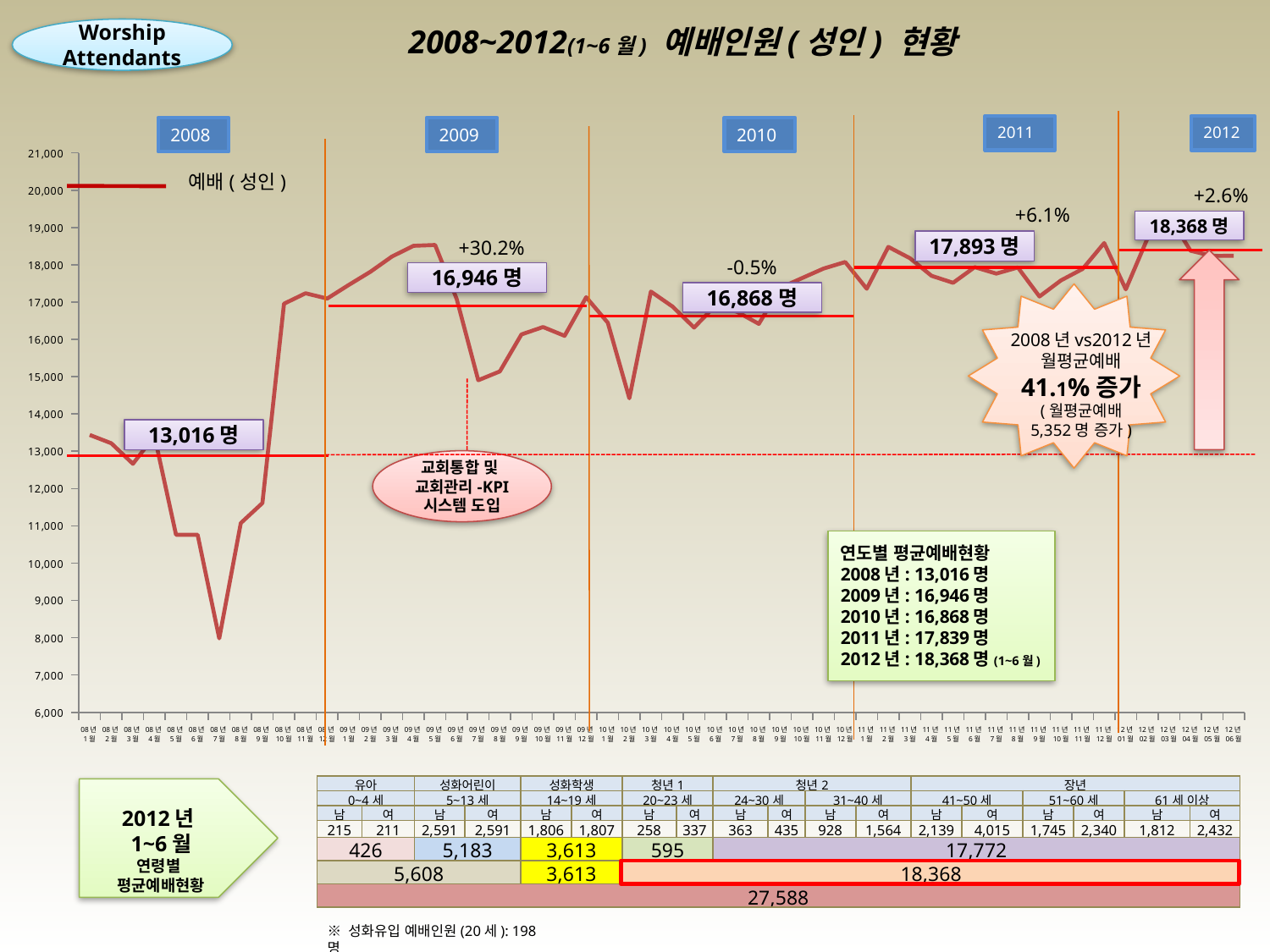
Which labelled average attendance is larger, 2009 or 2010? 2009 What is the labelled average worship attendance for 2009 on the chart? 16,946 명 What is the labelled average worship attendance for 2012 (Jan–Jun) on the chart? 18,368 명 What kind of chart is used to show the worship attendance from 2008 to 2012? line chart Which year has the lowest labelled average attendance on the chart? 2008 What is the labelled average worship attendance for 2010 on the chart? 16,868 명 What percentage change is shown on the chart for 2010? -0.5% What percentage change is shown on the chart for 2009? +30.2% Which year has the highest labelled average attendance on the chart? 2012 What is the difference between the labelled average attendance for 2009 and 2008? 3,930 명 What is the labelled average worship attendance for 2008 on the chart? 13,016 명 Is the lowest point of the line in 2008 greater or less than 9,000? less